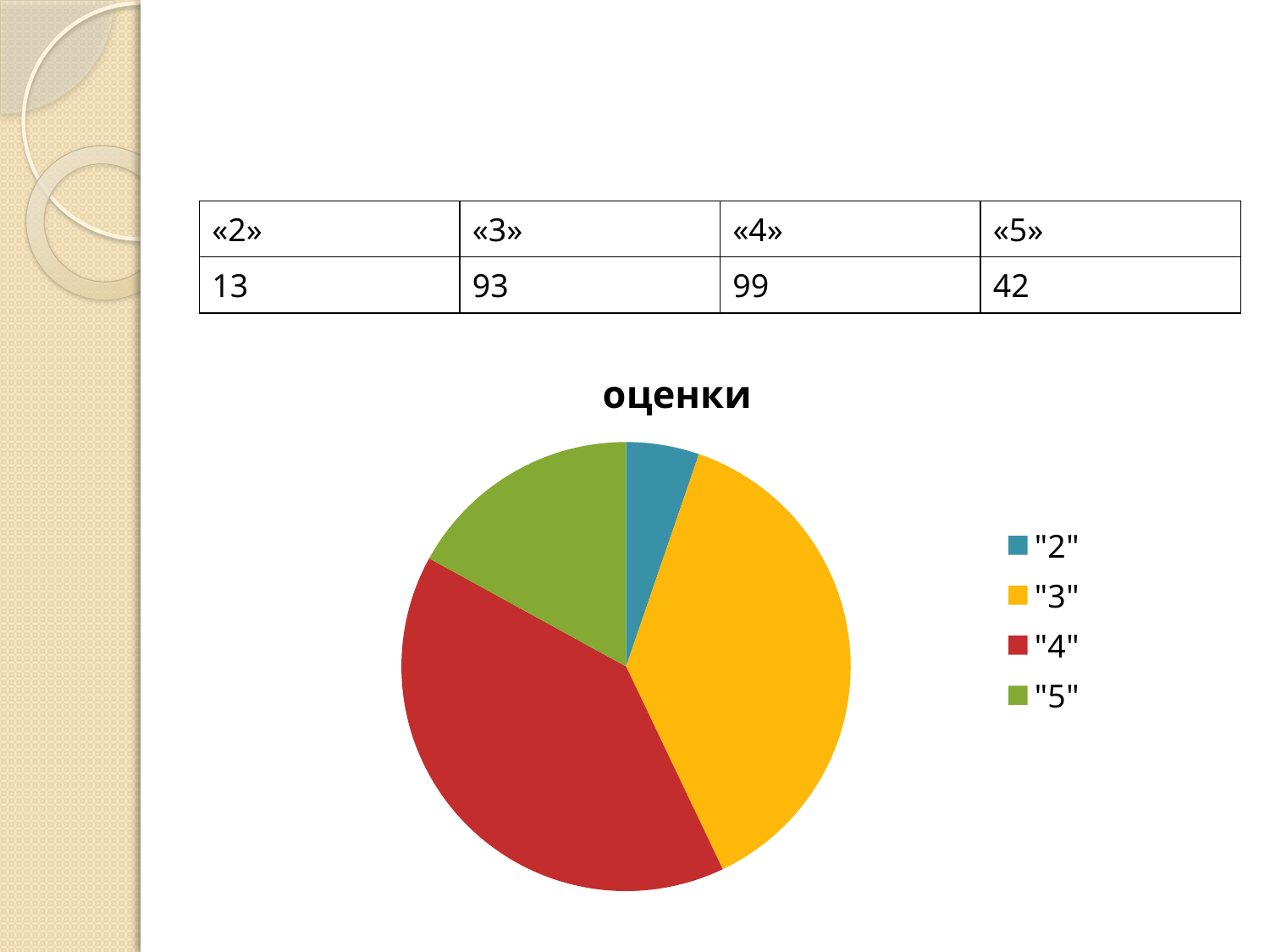
What is the value for "3" according to the table above the chart? 93 What is the title of the chart? оценки How many entries does the chart legend list? 4 What is the value for "2" according to the table above the chart? 13 Which category has the largest value in the table? "4" How many slices does the pie chart have? 4 What is the value for "5" according to the table above the chart? 42 Which is larger, the value for "3" or the value for "5"? "3" What is the difference between the values for "4" and "3"? 6 What kind of chart is shown on the slide? pie chart What colour is the slice for "4" in the pie chart? red Which category has the smallest slice in the pie chart? "2"